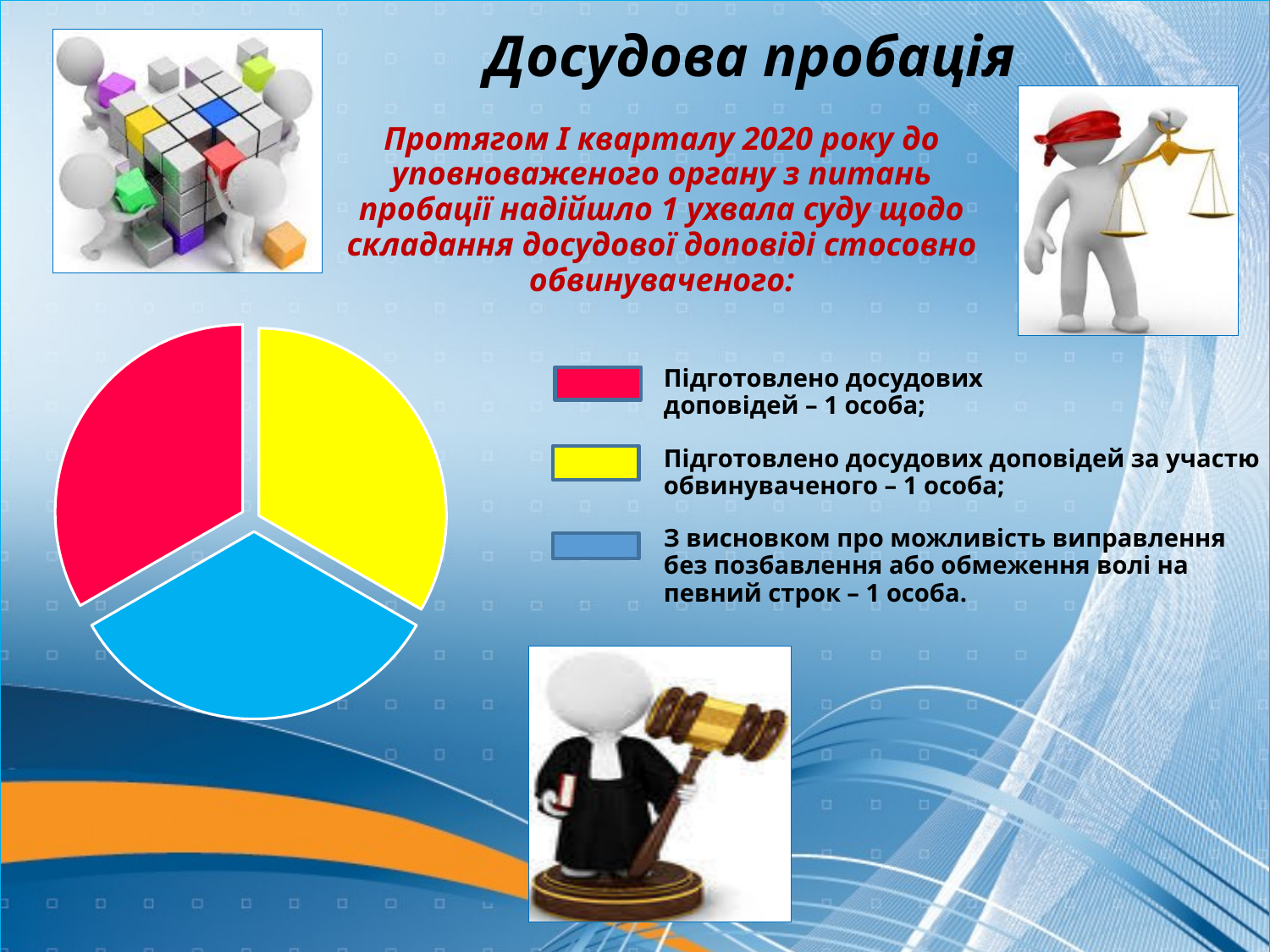
Which colour in the pie chart represents 'Підготовлено досудових доповідей за участю обвинуваченого'? yellow According to the legend, how many people does the red slice (Підготовлено досудових доповідей) represent? 1 особа How many slices does the pie chart have? 3 According to the legend, how many people does the blue slice (З висновком про можливість виправлення без позбавлення або обмеження волі на певний строк) represent? 1 особа What is the total of all three values shown in the legend of the pie chart? 3 What kind of chart is shown on the slide? pie chart How many entries does the legend next to the pie chart list? 3 What is the difference between the value for the red slice and the value for the yellow slice? 0 What is the title of the slide containing the pie chart? Досудова пробація According to the legend, how many people does the yellow slice (Підготовлено досудових доповідей за участю обвинуваченого) represent? 1 особа What share of the pie does the blue slice represent? one third